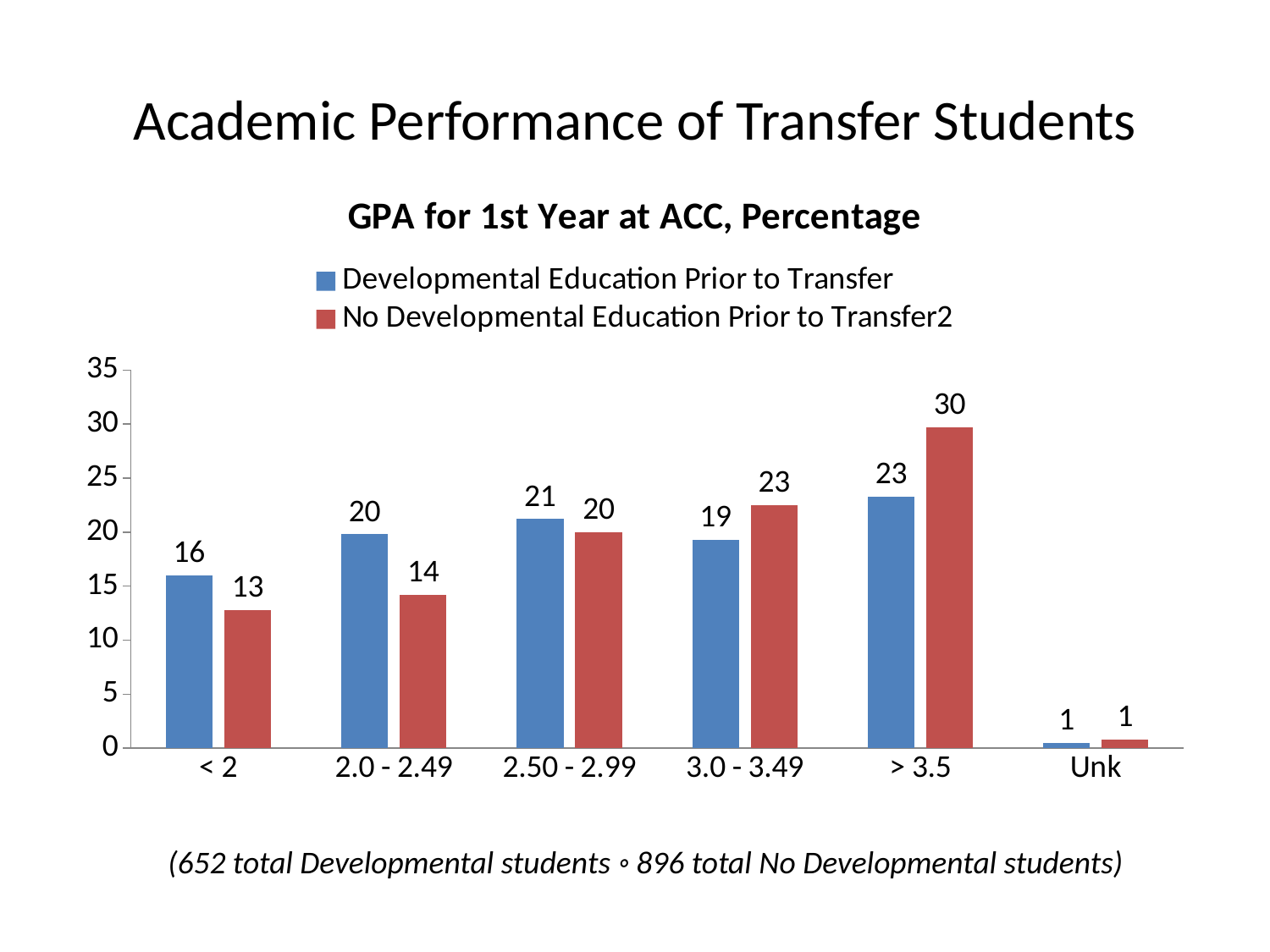
What is the value for No Developmental Education Prior to Transfer2 in the > 3.5 GPA category? 30 What is the title of the chart? GPA for 1st Year at ACC, Percentage What is the value for Developmental Education Prior to Transfer in the 2.50 - 2.99 category? 21 How many GPA categories are shown on the x axis? 6 In the 2.0 - 2.49 category, which series has the larger value? Developmental Education Prior to Transfer What is the difference between the two series in the > 3.5 category? 7 Is the value for No Developmental Education Prior to Transfer2 in the 3.0 - 3.49 category greater or less than 20? greater What kind of chart is shown on the slide? Bar chart How many series does the legend list? 2 Which GPA category has the lowest value for Developmental Education Prior to Transfer? Unk What is the value for Developmental Education Prior to Transfer in the < 2 GPA category? 16 Which GPA category has the highest value for No Developmental Education Prior to Transfer2? > 3.5